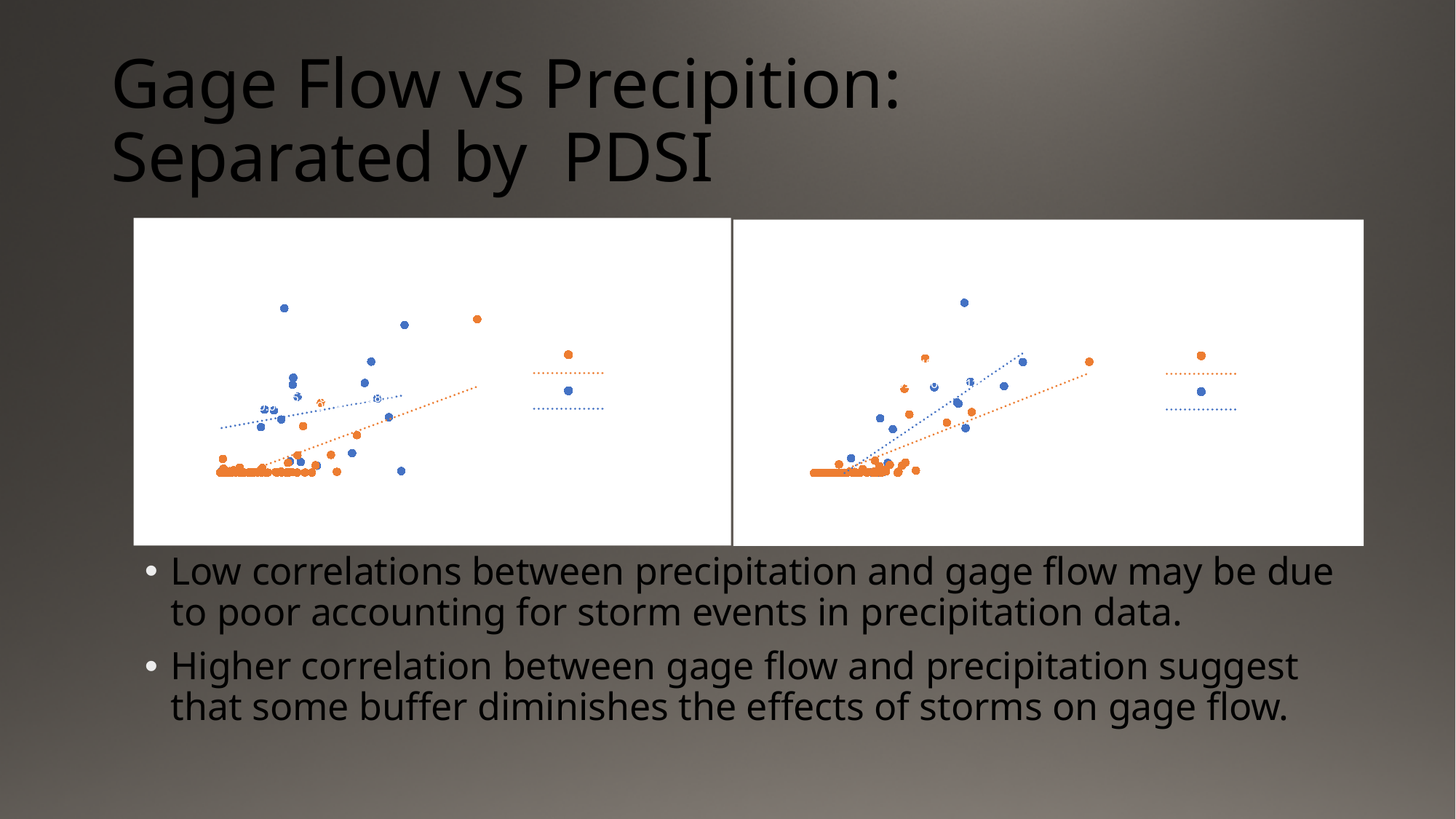
What kind of chart is the right chart on the slide? scatter chart How many colours of data points are plotted in the left chart? 2 In the left chart, which trendline is steeper, the blue one or the orange one? orange How many colours of data points are plotted in the right chart? 2 In the right chart, does the orange dotted trendline rise or fall from left to right? rise What kind of chart is the left chart on the slide? scatter chart In the right chart, which trendline is steeper, the blue one or the orange one? blue In the left chart, does the blue dotted trendline rise or fall from left to right? rise In the left chart, does the orange dotted trendline rise or fall from left to right? rise What two colours are used for the data points in both charts? blue and orange In the left chart, which colour of points is mostly clustered along the bottom of the plot? orange